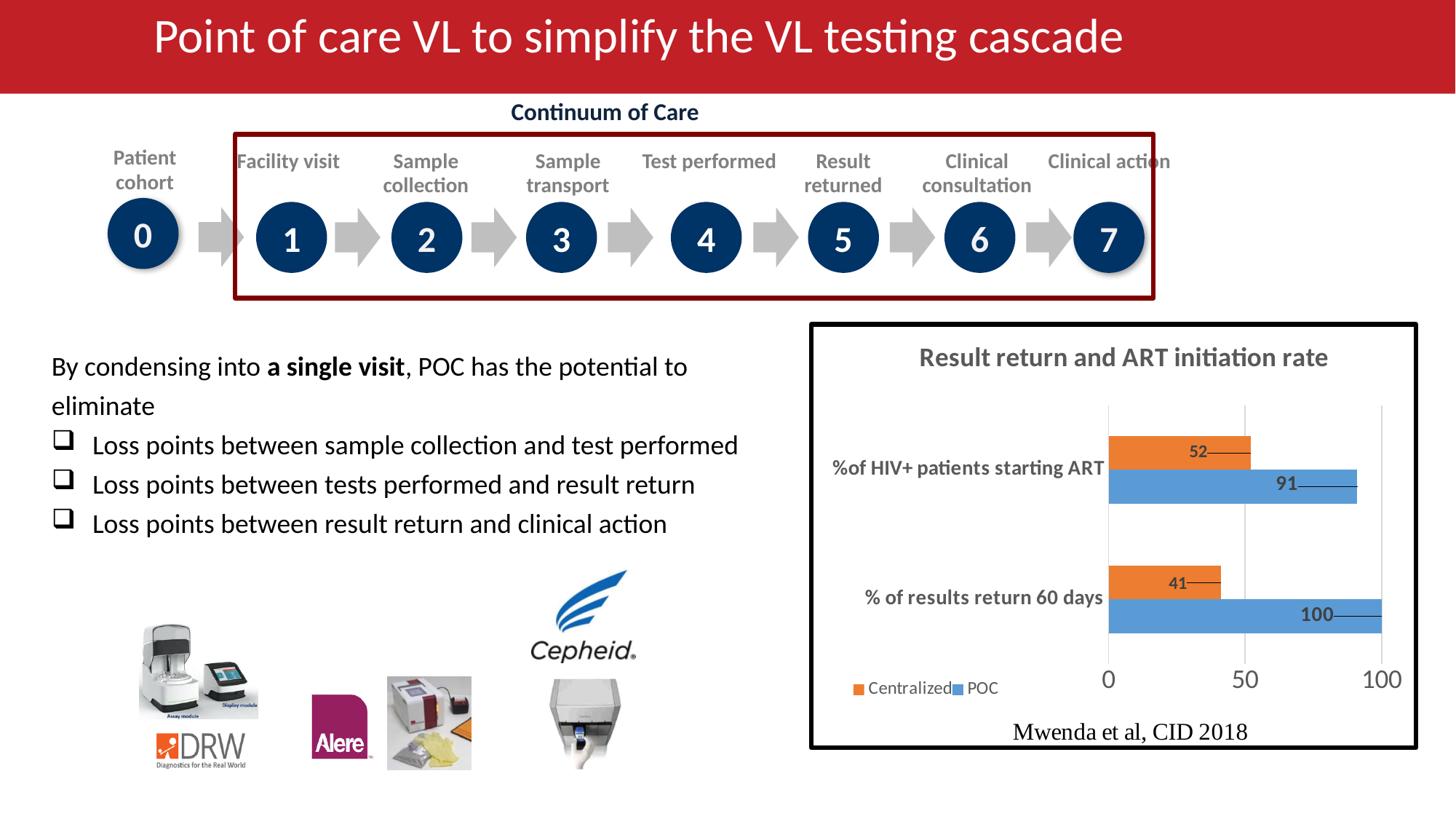
How many categories are shown on the chart? 2 Which series has the larger value for '%of HIV+ patients starting ART', Centralized or POC? POC What is the difference between the POC and Centralized values for '% of results return 60 days'? 59 How many series does the chart legend list? 2 What is the Centralized value for '% of results return 60 days'? 41 What type of chart is shown on the slide? bar chart Which category has the lowest Centralized value? % of results return 60 days What is the POC value for '%of HIV+ patients starting ART'? 91 What is the Centralized value for '%of HIV+ patients starting ART'? 52 What is the POC value for '% of results return 60 days'? 100 What is the title of the chart on the slide? Result return and ART initiation rate What is the difference between the POC and Centralized values for '%of HIV+ patients starting ART'? 39